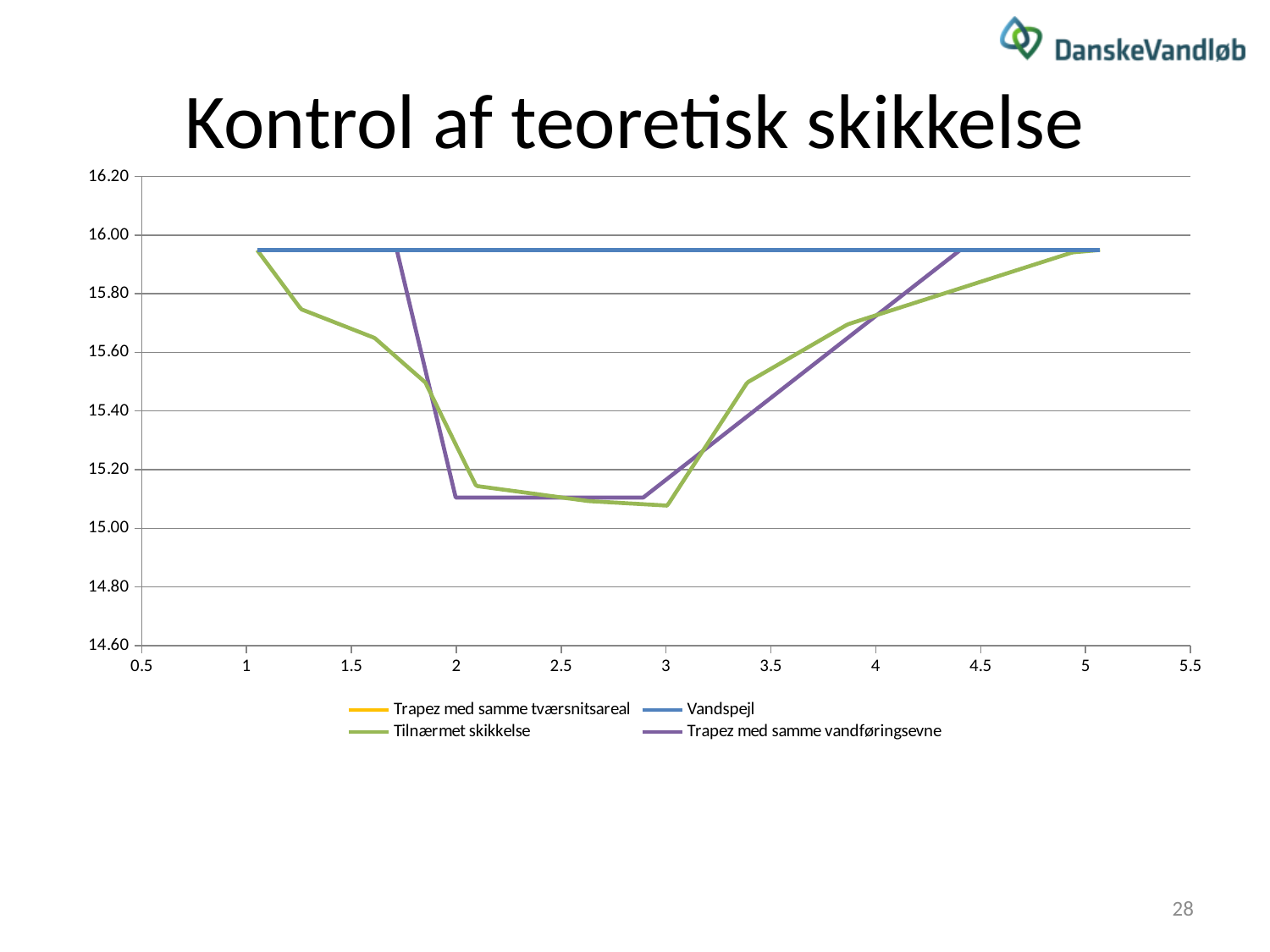
Which series is drawn in purple? Trapez med samme vandføringsevne Is the value of Trapez med samme vandføringsevne at x = 2 greater or less than 15.20? less Is the value of the Vandspejl line greater or less than 15.80? greater At x = 3.5, which series has the higher value: Tilnærmet skikkelse or Trapez med samme vandføringsevne? Tilnærmet skikkelse Does the Tilnærmet skikkelse line rise or fall between x = 3 and x = 5? rise Is the value of Tilnærmet skikkelse at x = 1.5 greater or less than 15.60? greater How many series does the legend list? 4 What kind of chart is shown on the slide? Line chart Does the Tilnærmet skikkelse line rise or fall between x = 1 and x = 3? fall At x = 1.5, which series has the higher value: Tilnærmet skikkelse or Trapez med samme vandføringsevne? Trapez med samme vandføringsevne What is the title of the chart? Kontrol af teoretisk skikkelse